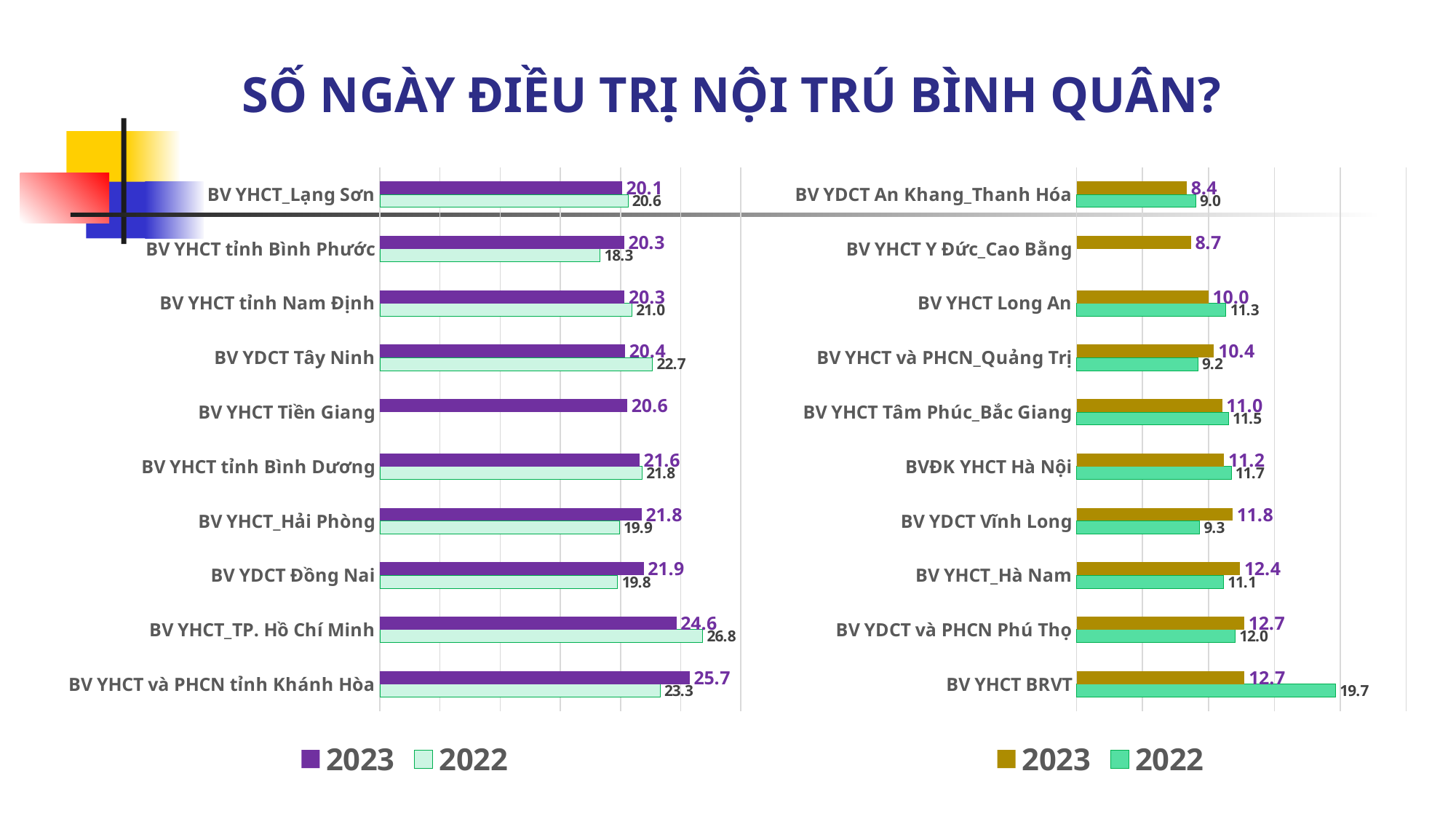
In the right chart, what is the difference between the 2022 and 2023 values for BV YHCT BRVT? 7.0 How many series does the legend of the left chart list? 2 What type of chart is the left chart? Bar chart How many categories are shown in the right chart? 10 In the left chart, what is the 2023 value for BV YHCT_Lạng Sơn? 20.1 In the left chart, which category has the highest 2023 value? BV YHCT và PHCN tỉnh Khánh Hòa In the left chart, what is the 2022 value for BV YHCT_TP. Hồ Chí Minh? 26.8 In the left chart, what is the difference between the 2023 and 2022 values for BV YDCT Tây Ninh? 2.3 In the right chart, what is the 2023 value for BV YHCT Y Đức_Cao Bằng? 8.7 In the right chart, what is the 2022 value for BV YHCT BRVT? 19.7 In the right chart, which category has the lowest 2023 value? BV YDCT An Khang_Thanh Hóa In the left chart, which is larger for BV YHCT_Hải Phòng: the 2023 value or the 2022 value? 2023